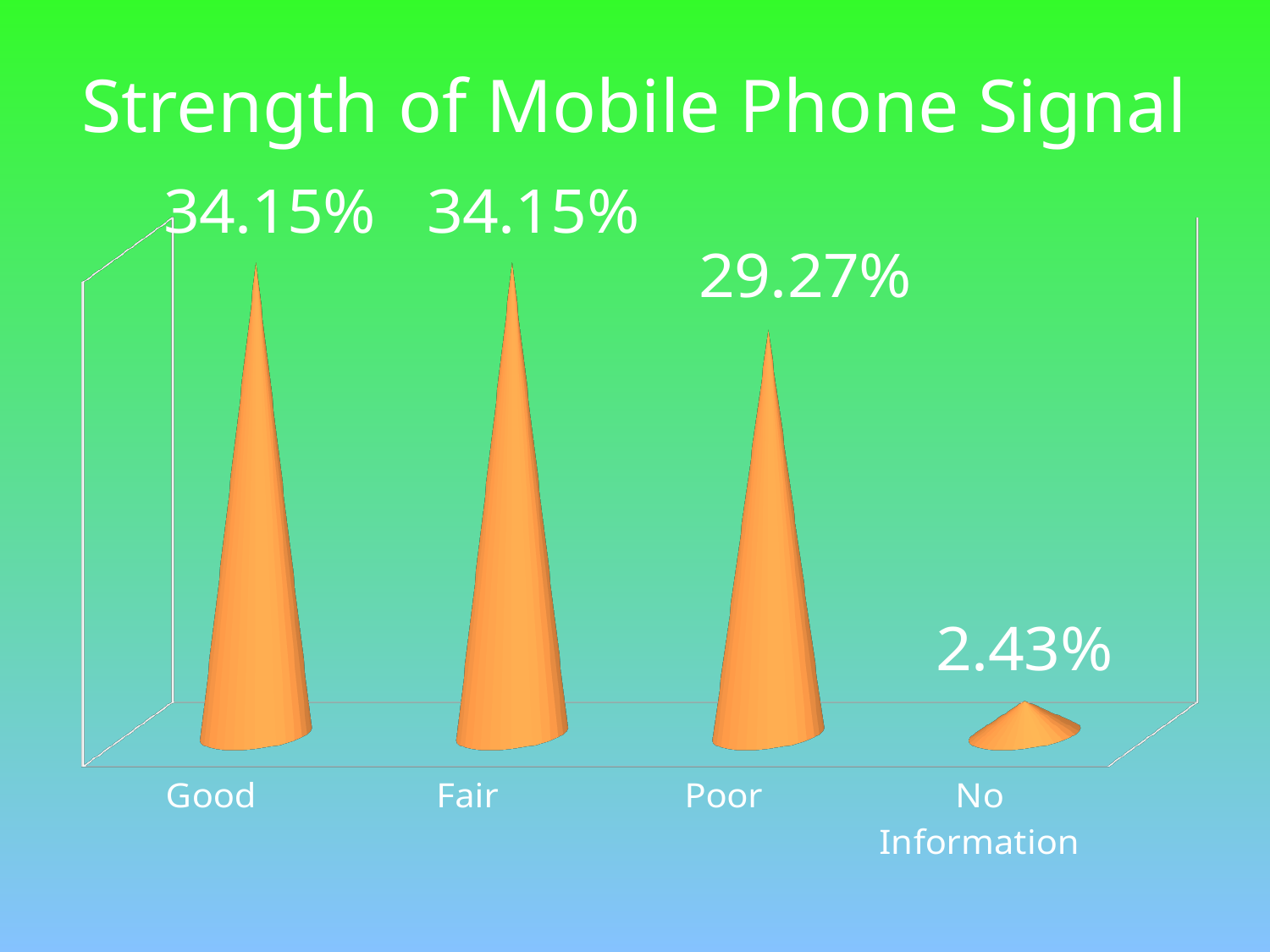
Do Good and Fair have the same value? Yes Which category has the lowest value? No Information Which is larger, the value for Poor or the value for No Information? Poor What is the value for Fair? 34.15% What is the value for No Information? 2.43% What is the difference between the values for Poor and No Information? 26.84% What is the value for Good? 34.15% What is the value for Poor? 29.27% What is the title of the chart? Strength of Mobile Phone Signal What kind of chart is shown on the slide? Bar chart What is the difference between the values for Good and Poor? 4.88% How many categories are shown on the chart? 4